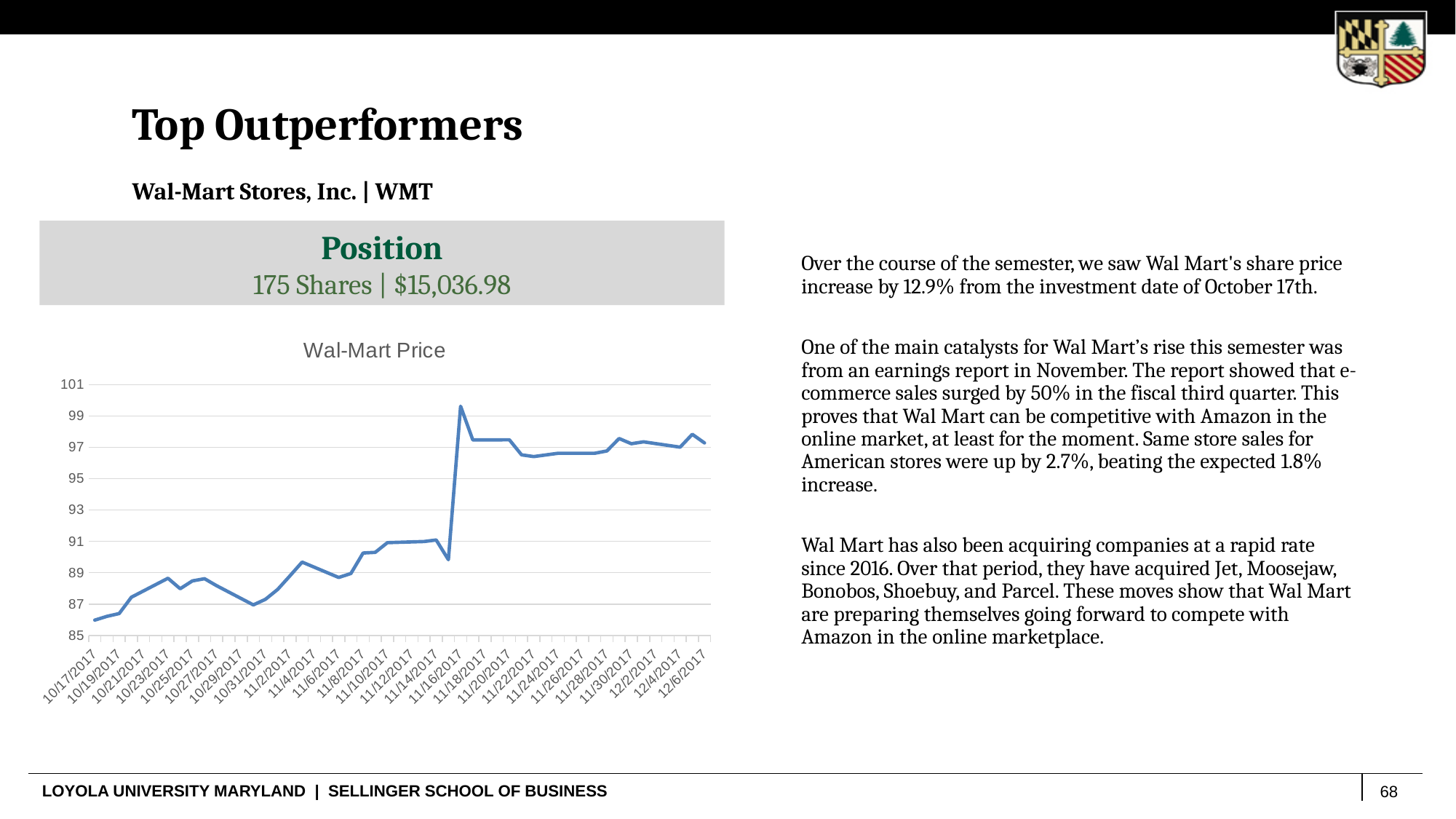
How many date labels are shown on the x axis of the Wal-Mart Price chart? 26 Overall, does the Wal-Mart price rise or fall from 10/17/2017 to 12/6/2017? rise What is the title of the chart on the slide? Wal-Mart Price Which date has the higher Wal-Mart price, 11/14/2017 or 11/22/2017? 11/22/2017 Is the Wal-Mart price on 11/14/2017 greater or less than 89? greater On which date is the Wal-Mart price lowest in the chart? 10/17/2017 Is the Wal-Mart price on 11/16/2017 greater or less than 99? greater Is the Wal-Mart price on 10/17/2017 greater or less than 87? less What kind of chart is the "Wal-Mart Price" chart? line chart On which date does the Wal-Mart price reach its highest point in the chart? 11/16/2017